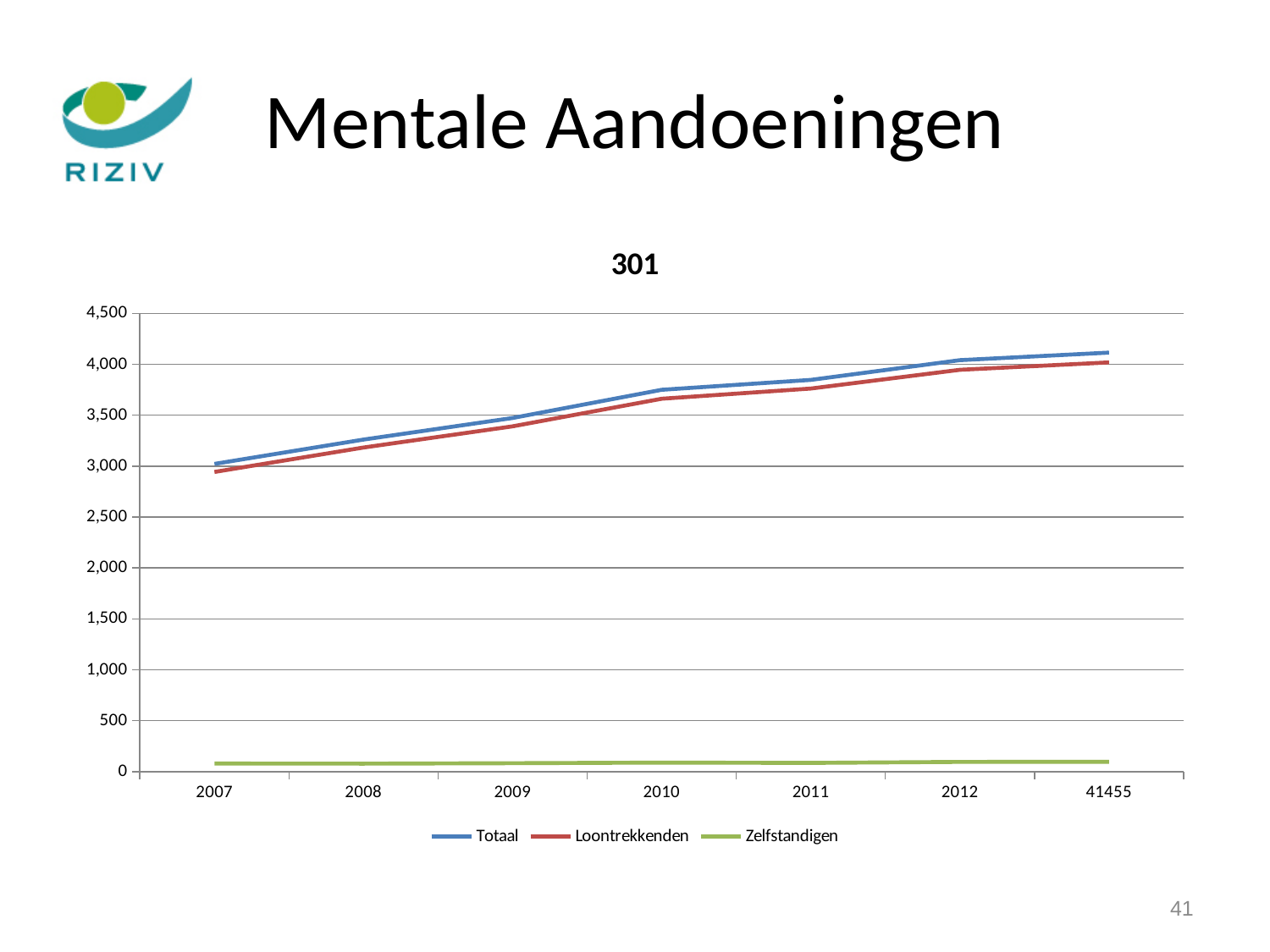
How many series does the legend list? 3 Is the value for Totaal in 2007 greater or less than 2,500? greater How many points are plotted along the x axis for each series? 7 What is the title of the chart? 301 Is the value for Zelfstandigen in 2012 greater or less than 500? less Does the Totaal series rise or fall from 2007 to the last point? rise Is the value for Loontrekkenden in 2012 greater or less than 3,500? greater What kind of chart is shown on the slide? line chart Does the Loontrekkenden series rise or fall across the x axis? rise Which is larger in 2010, the value for Totaal or the value for Zelfstandigen? Totaal Which series has the lowest values throughout the chart? Zelfstandigen